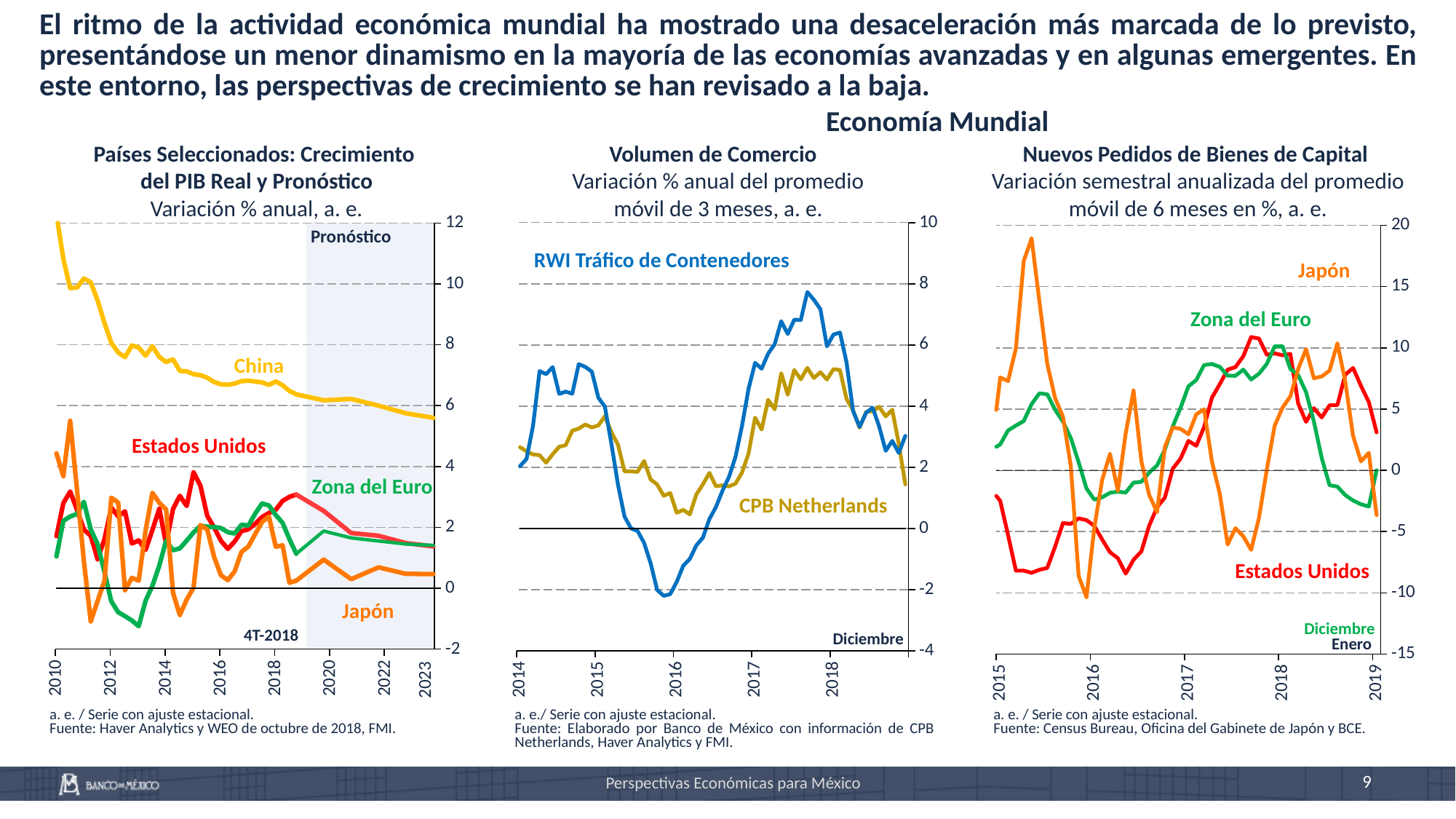
In the middle chart, 'Volumen de Comercio', which series reaches a higher peak in 2017–2018, RWI Tráfico de Contenedores or CPB Netherlands? RWI Tráfico de Contenedores What kind of chart is the left chart, 'Países Seleccionados: Crecimiento del PIB Real y Pronóstico'? Line chart In the left chart, 'Países Seleccionados: Crecimiento del PIB Real y Pronóstico', which series has the highest values across the whole period? China In the left chart, 'Países Seleccionados: Crecimiento del PIB Real y Pronóstico', does the China series rise or fall from 2010 to 2023? Fall In the right chart, 'Nuevos Pedidos de Bienes de Capital', which series is plotted in green? Zona del Euro In the middle chart, 'Volumen de Comercio', is the peak value of RWI Tráfico de Contenedores in late 2017 greater or less than 6? greater In the middle chart, 'Volumen de Comercio', how many series are plotted? 2 In the left chart, 'Países Seleccionados: Crecimiento del PIB Real y Pronóstico', is the value for China at the start of 2010 greater or less than 10? greater In the right chart, 'Nuevos Pedidos de Bienes de Capital', is the peak value for Japón in 2015 greater or less than 15? greater In the left chart, 'Países Seleccionados: Crecimiento del PIB Real y Pronóstico', how many countries or regions are plotted? 4 In the left chart, 'Países Seleccionados: Crecimiento del PIB Real y Pronóstico', what label marks the shaded area on the right? Pronóstico